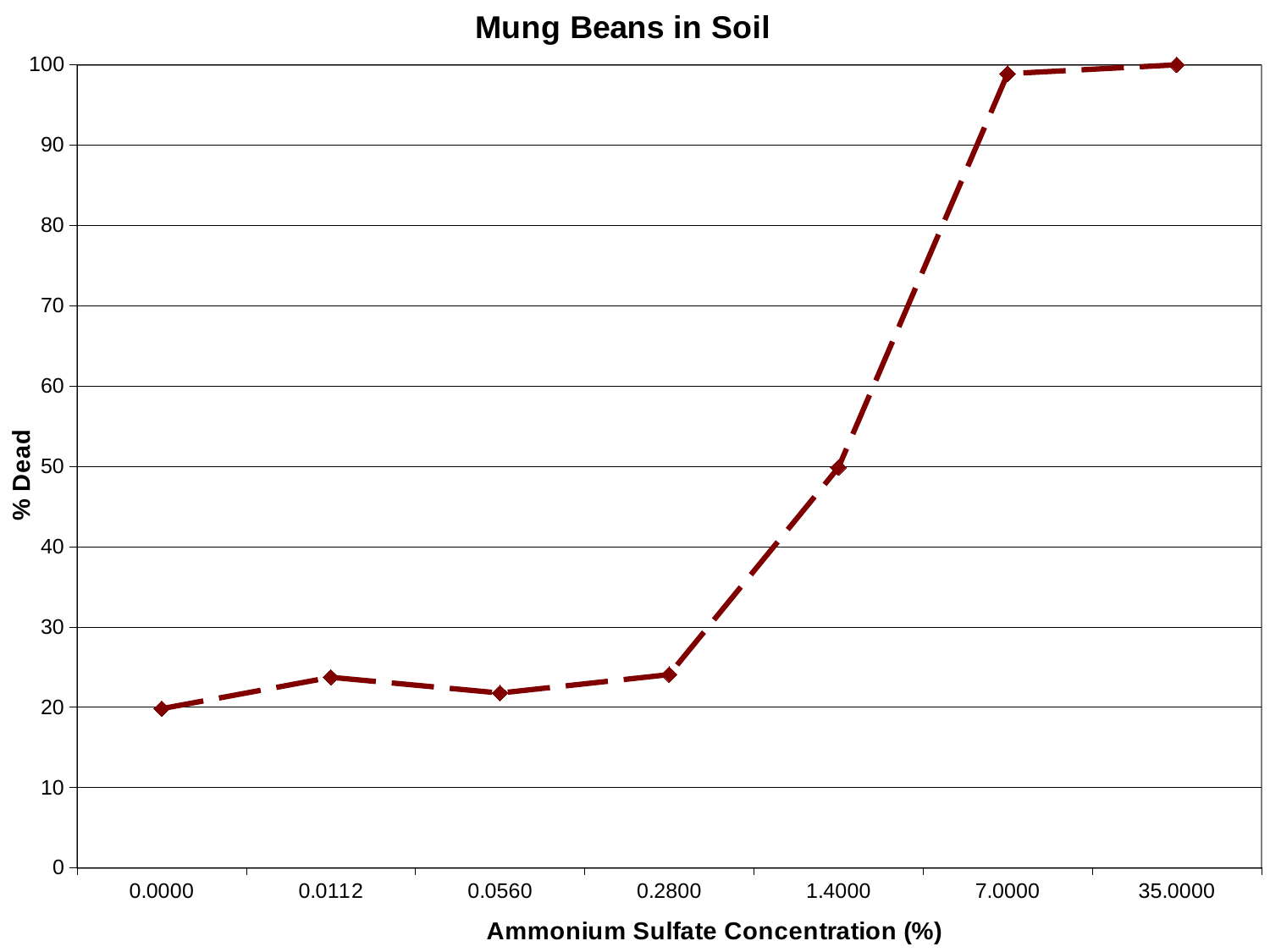
Is the % Dead value at a concentration of 7.0000 greater or less than 90? greater How many data points are plotted on the line? 7 Is the % Dead value at a concentration of 0.0112 greater or less than 20? greater Which concentration has the lowest % Dead value? 0.0000 What is the % Dead value at an ammonium sulfate concentration of 35.0000? 100 Is the % Dead value at a concentration of 0.2800 greater or less than 30? less Overall, does the % Dead value rise or fall as the ammonium sulfate concentration increases along the x axis? rise What kind of chart is shown on the slide? line chart What is the title of the chart? Mung Beans in Soil What is the label of the x axis? Ammonium Sulfate Concentration (%) Which has a higher % Dead value, a concentration of 0.2800 or 1.4000? 1.4000